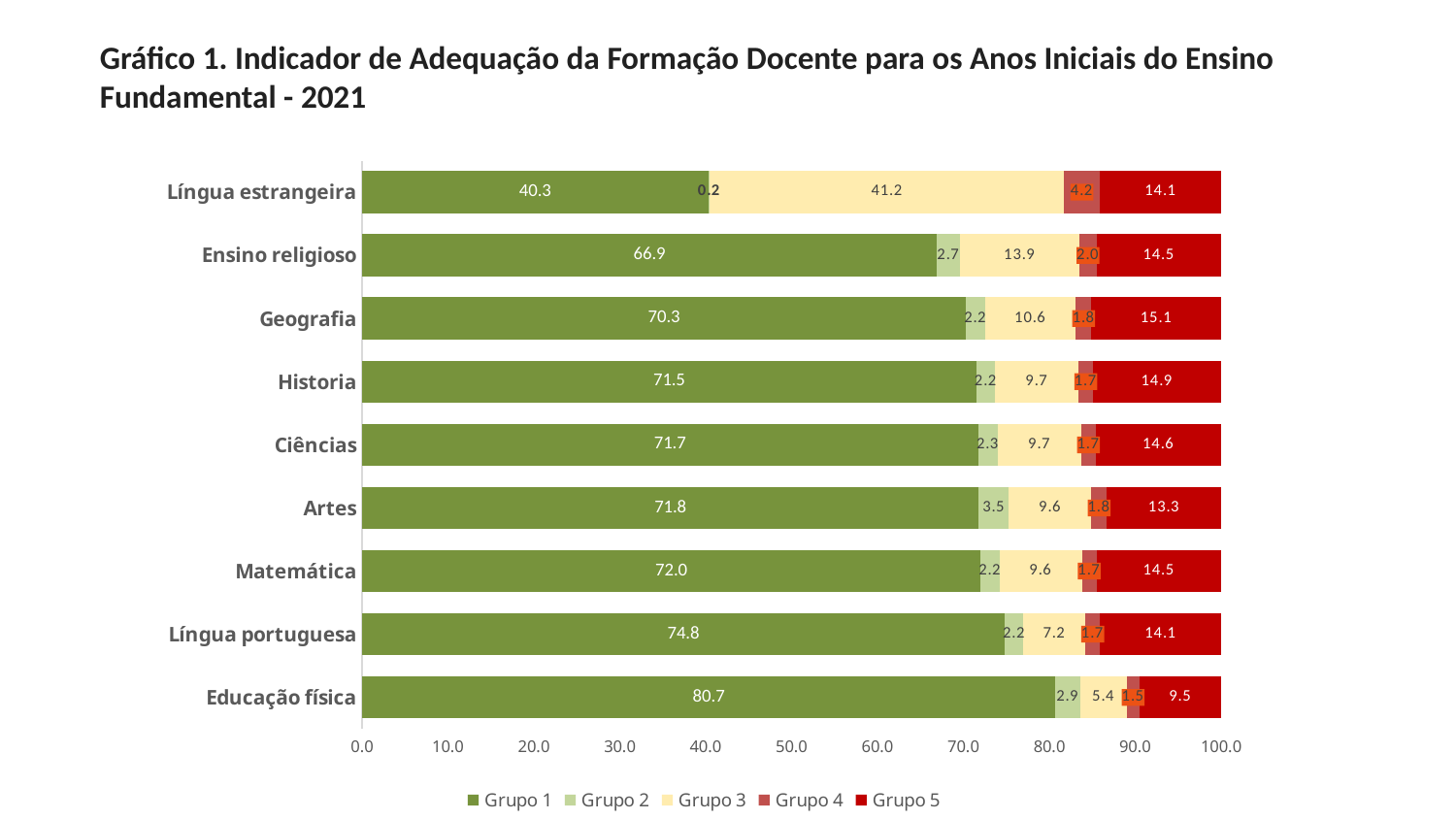
How many categories are shown on the y axis? 9 Which is larger: the Grupo 5 value for Artes or for Ensino religioso? Ensino religioso Which category has the lowest Grupo 1 value? Língua estrangeira What kind of chart is this? Stacked bar chart What is the Grupo 1 value for Educação física? 80.7 Which category has the highest Grupo 1 value? Educação física How many series does the legend list? 5 What is the Grupo 3 value for Língua estrangeira? 41.2 What is the Grupo 5 value for Geografia? 15.1 What is the total of the Grupo 1 and Grupo 3 values for Língua estrangeira? 81.5 What is the name of the last series in the legend? Grupo 5 What is the difference between the Grupo 1 values for Língua portuguesa and Matemática? 2.8